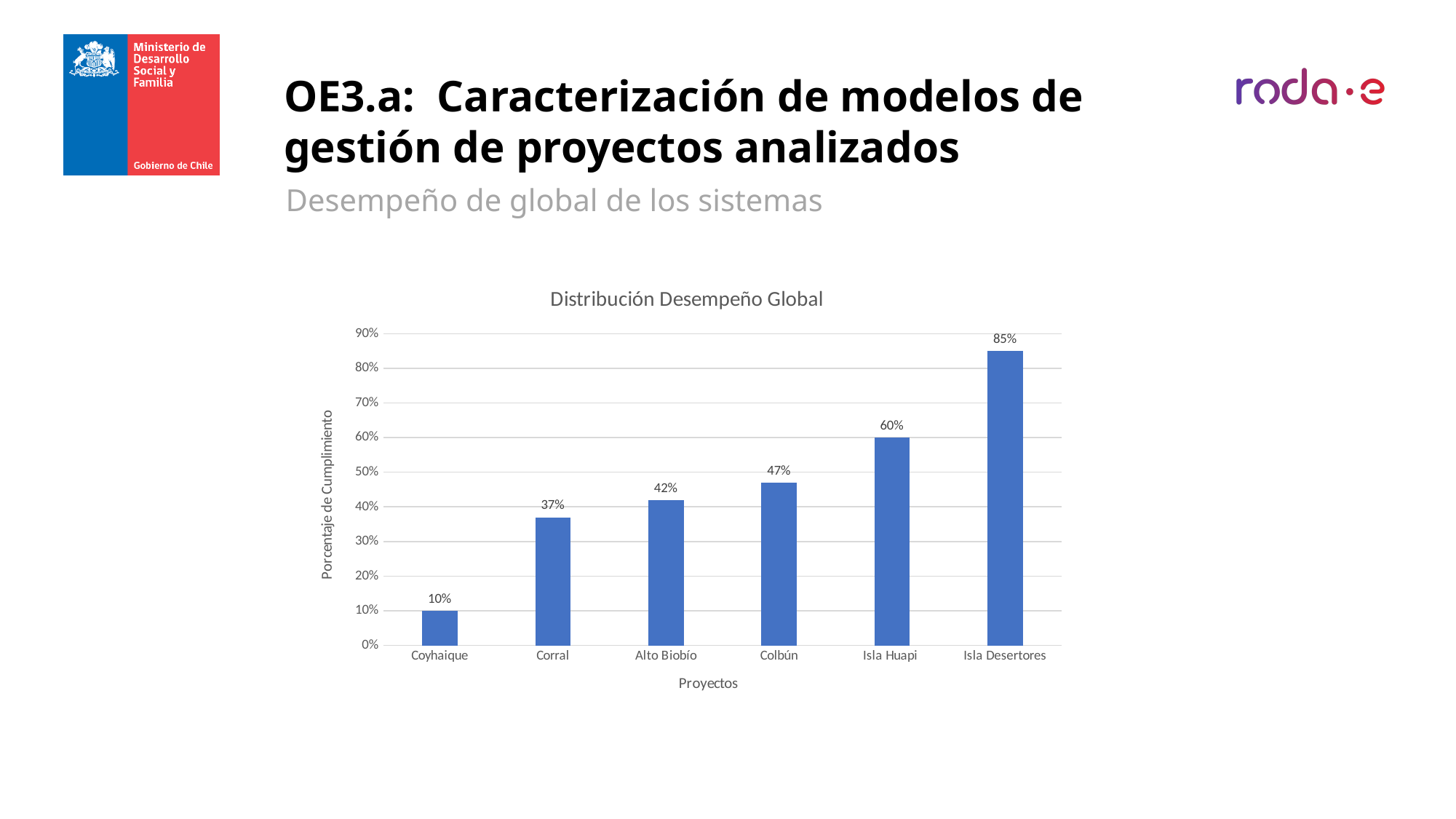
What is the value for Coyhaique? 10% What is the difference between the values for Isla Desertores and Isla Huapi? 25% What is the difference between the values for Alto Biobío and Corral? 5% What is the title of the chart? Distribución Desempeño Global What kind of chart is shown? bar chart Which project has the lowest value? Coyhaique Which is larger, the value for Corral or the value for Colbún? Colbún What is the value for Isla Huapi? 60% What is the value for Colbún? 47% Is the value for Alto Biobío greater or less than 50%? less Which project has the highest value? Isla Desertores How many projects are shown on the x axis? 6